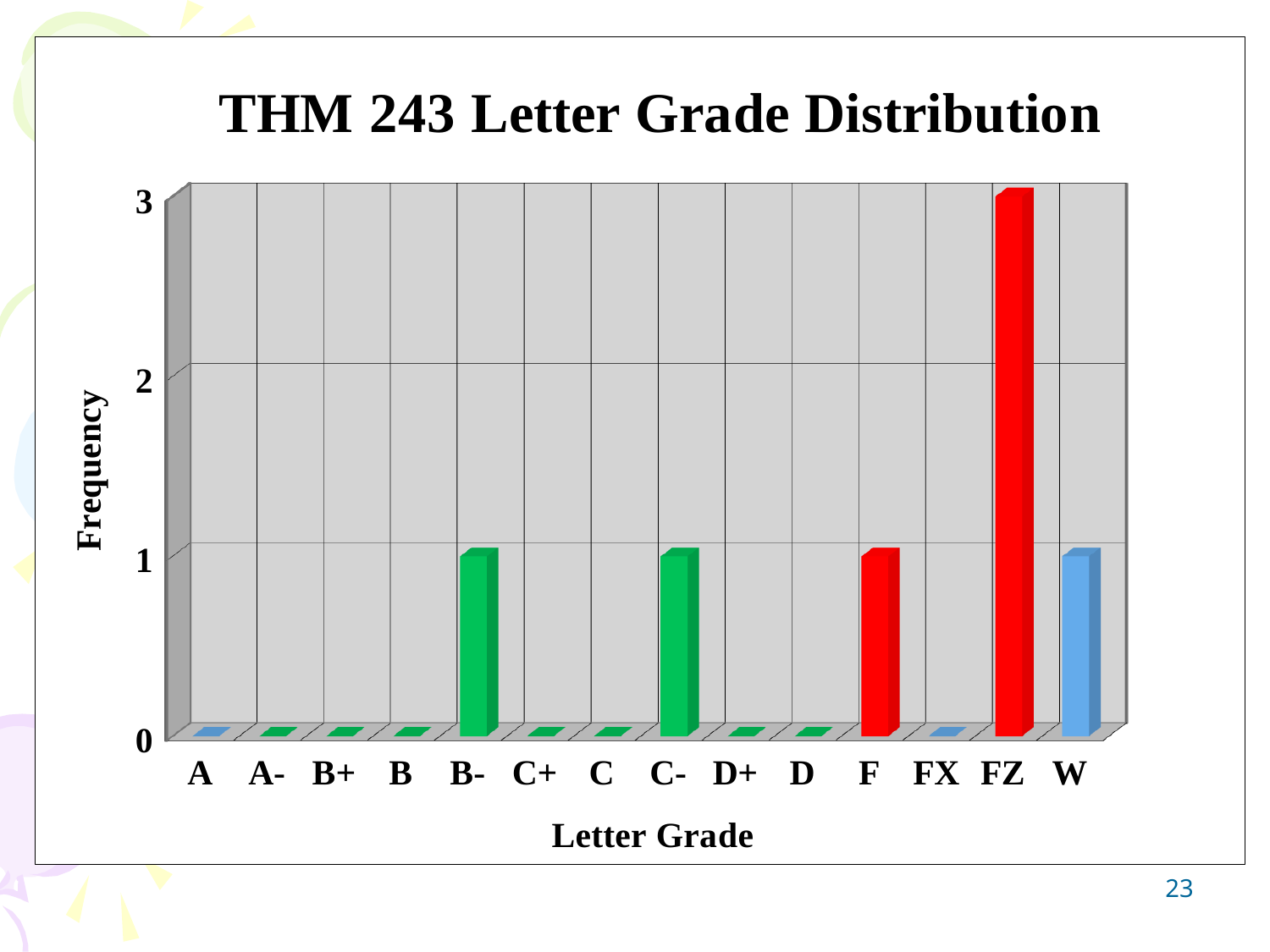
What is the label of the y axis? Frequency What is the frequency for letter grade FZ? 3 What kind of chart is shown on the slide? bar chart What is the frequency for letter grade A? 0 How many letter grade categories are shown on the x axis? 14 Is the frequency for FZ greater or less than 2? greater What is the title of the chart? THM 243 Letter Grade Distribution Which letter grade has the highest frequency? FZ What is the difference in frequency between FZ and F? 2 What is the frequency for letter grade B-? 1 Which has a higher frequency, C- or C+? C- What is the frequency for letter grade W? 1